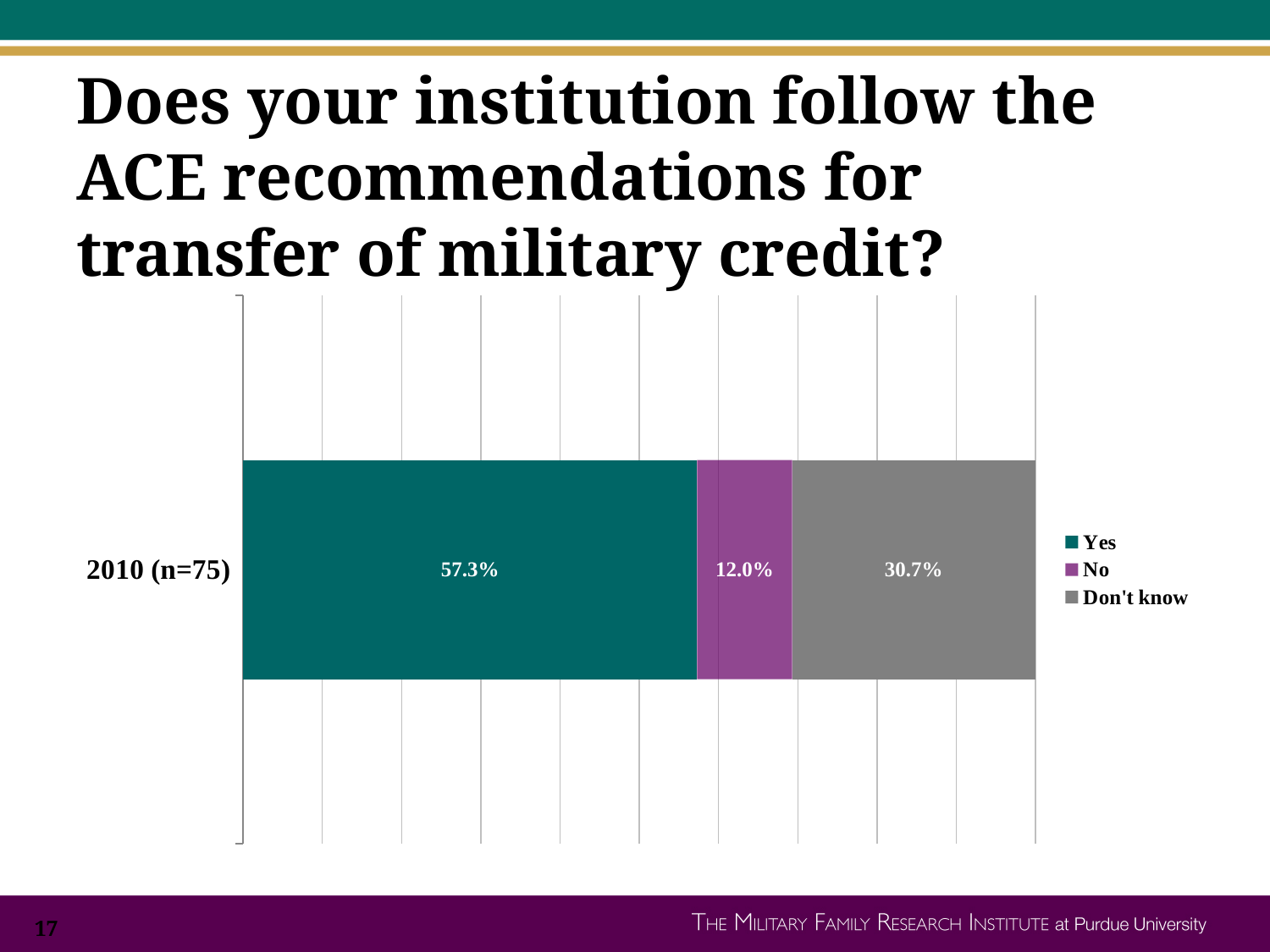
What is the difference between the "Yes" and "Don't know" percentages? 26.6% Which is larger, the "No" share or the "Don't know" share? Don't know How many series does the legend list? 3 What is the sample size shown for the 2010 category label? n=75 What percentage of institutions answered "Don't know" in 2010? 30.7% What kind of chart is shown on the slide? Stacked bar chart Which response has the largest share in the 2010 bar? Yes What is the total of the three segments in the 2010 bar? 100.0% What percentage of institutions answered "No" in 2010? 12.0% What percentage of institutions answered "Yes" in 2010? 57.3% Which response has the smallest share in the 2010 bar? No What is the difference between the "Don't know" and "No" percentages? 18.7%